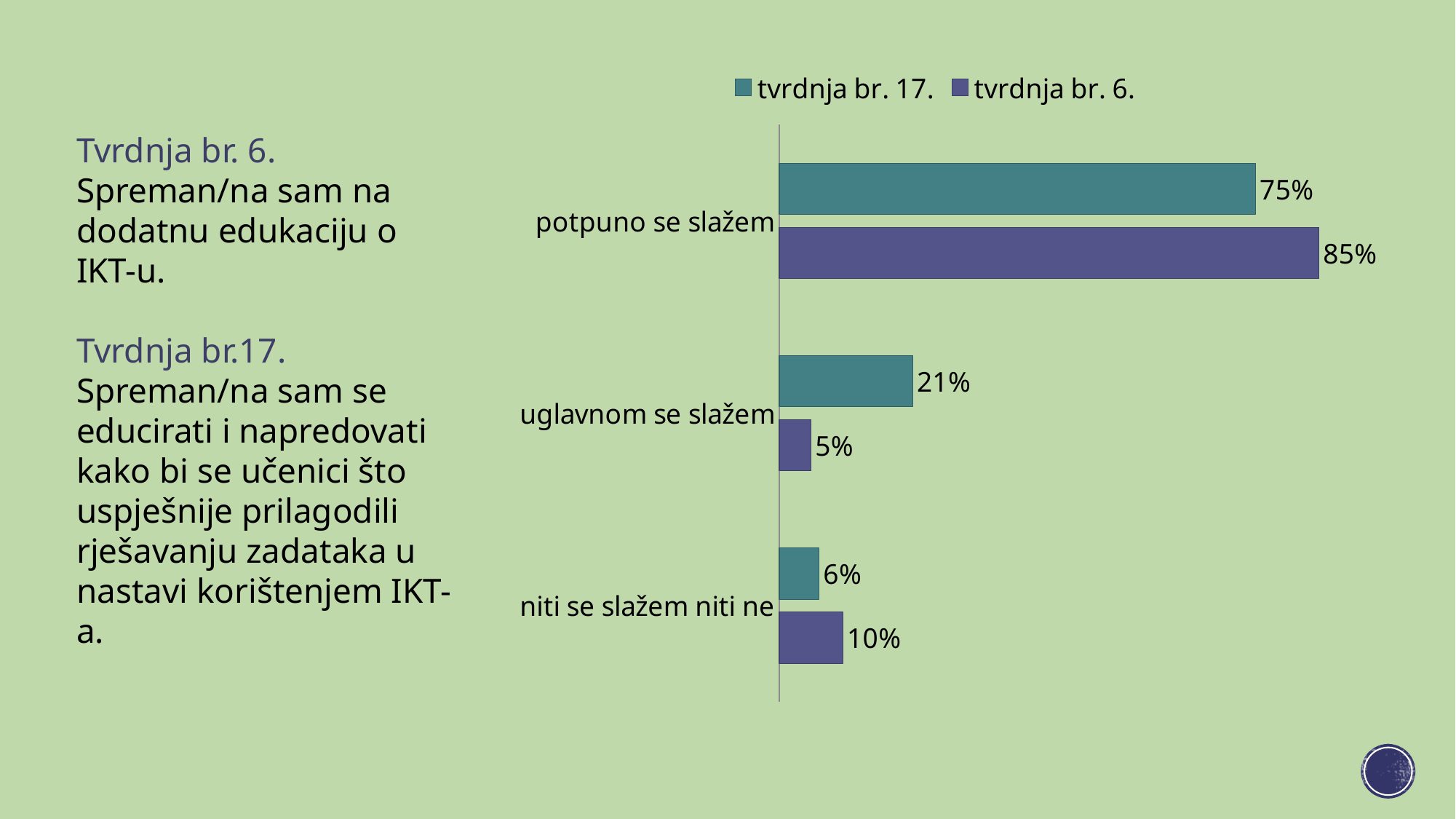
What is the value for "tvrdnja br. 6." in the "potpuno se slažem" category? 85% Which category has the highest value for "tvrdnja br. 17."? potpuno se slažem What is the value for "tvrdnja br. 17." in the "uglavnom se slažem" category? 21% How many categories are shown on the chart? 3 How many series does the legend list? 2 What is the difference between "tvrdnja br. 6." and "tvrdnja br. 17." in the "potpuno se slažem" category? 10% What is the value for "tvrdnja br. 6." in the "niti se slažem niti ne" category? 10% Which category has the lowest value for "tvrdnja br. 6."? uglavnom se slažem Which series has the larger value in the "niti se slažem niti ne" category? tvrdnja br. 6. What is the value for "tvrdnja br. 17." in the "niti se slažem niti ne" category? 6% What is the difference between "tvrdnja br. 17." and "tvrdnja br. 6." in the "uglavnom se slažem" category? 16% What kind of chart is shown on the slide? bar chart